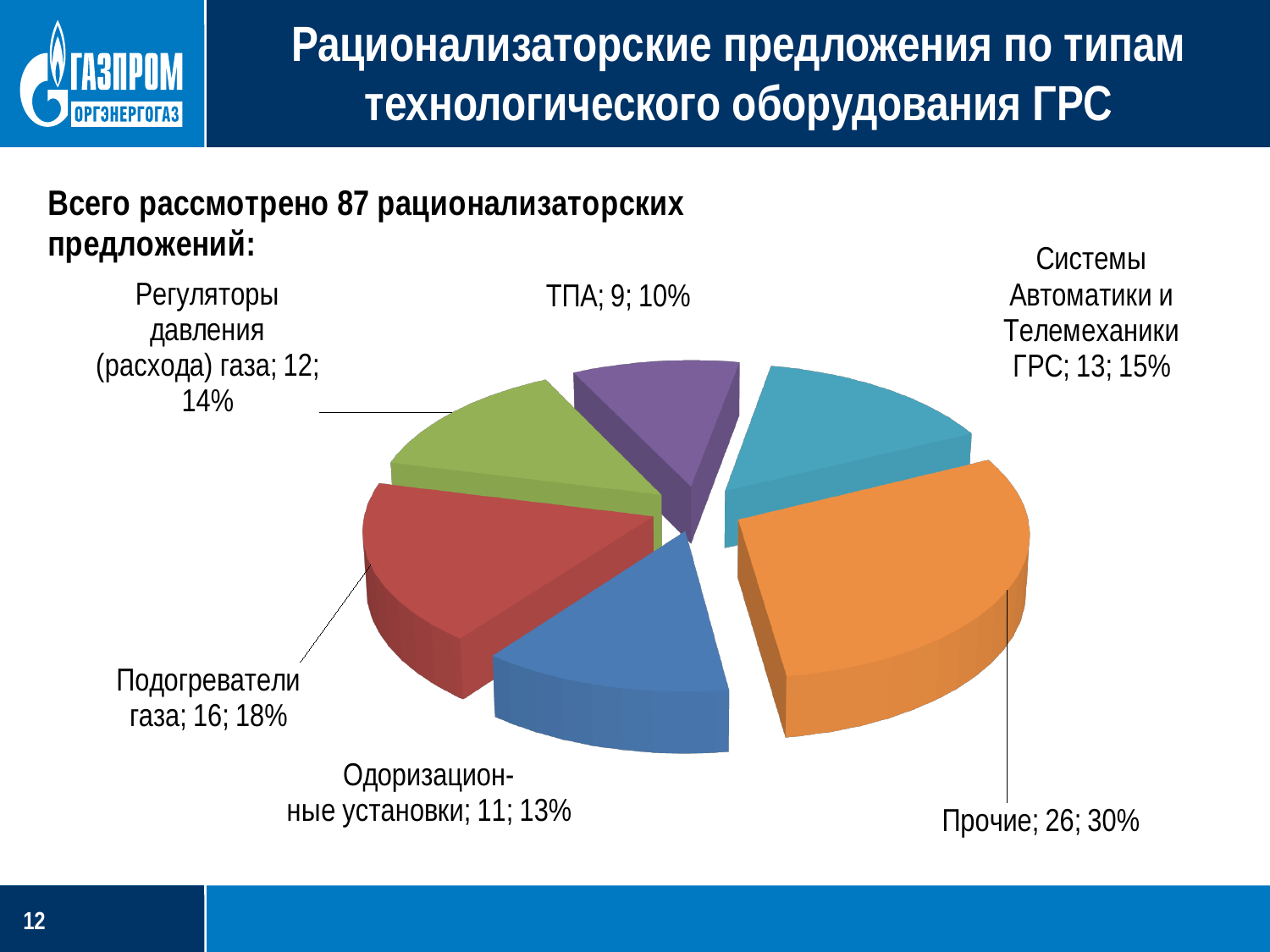
What kind of chart is shown on the slide? Pie chart How many rationalization proposals are in the "Прочие" slice? 26 How many proposals are in the "Подогреватели газа" category? 16 Which category has the largest slice of the pie? Прочие How many slices does the pie chart have? 6 According to the text on the slide, how many rationalization proposals were reviewed in total? 87 What share of the pie does "Прочие" represent? 30% What is the difference in the number of proposals between "Прочие" and "Подогреватели газа"? 10 What share of the pie is shown for "Регуляторы давления (расхода) газа"? 14% Which category has the smallest slice of the pie? ТПА What percentage is shown for "ТПА"? 10% Which has more proposals: "Системы Автоматики и Телемеханики ГРС" or "Одоризационные установки"? Системы Автоматики и Телемеханики ГРС